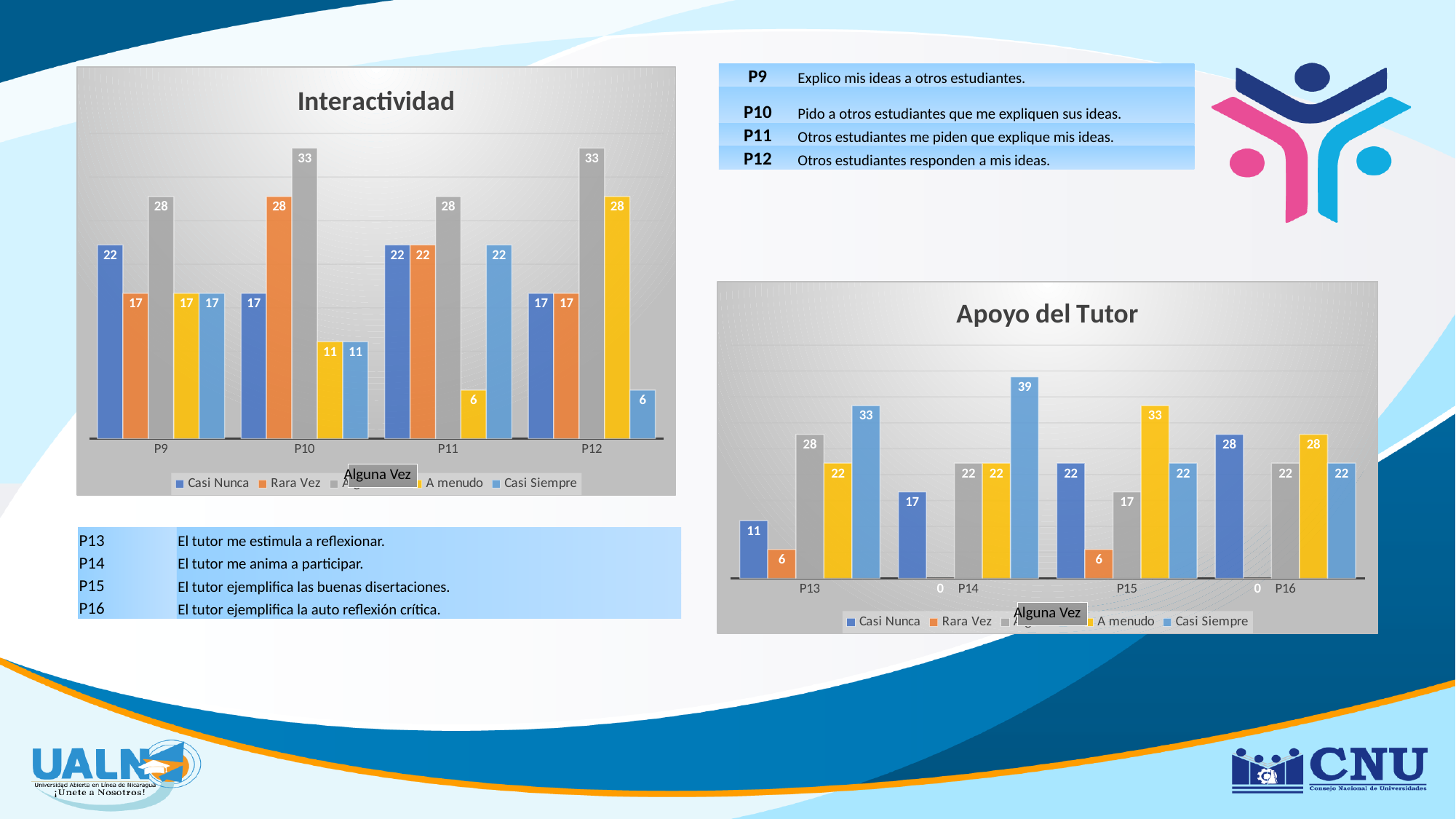
In the Interactividad chart, what is the difference between Rara Vez and A menudo for P10? 17 In the Apoyo del Tutor chart, what is the value of Rara Vez for P16? 0 How many series does the legend of the Apoyo del Tutor chart list? 5 In the Apoyo del Tutor chart, what is the value of Casi Siempre for P14? 39 In the Interactividad chart, which series has the highest value for P9? Alguna Vez In the Interactividad chart, what is the value of Casi Siempre for P12? 6 In the Interactividad chart, which series has the lowest value for P11? A menudo In the Apoyo del Tutor chart, which series has the highest value for P15? A menudo In the Apoyo del Tutor chart, which is larger for P13: Casi Nunca or Alguna Vez? Alguna Vez In the Apoyo del Tutor chart, what is the difference between Casi Siempre and Casi Nunca for P13? 22 In the Interactividad chart, what is the value of Alguna Vez for P10? 33 What kind of chart is the Interactividad chart? Bar chart